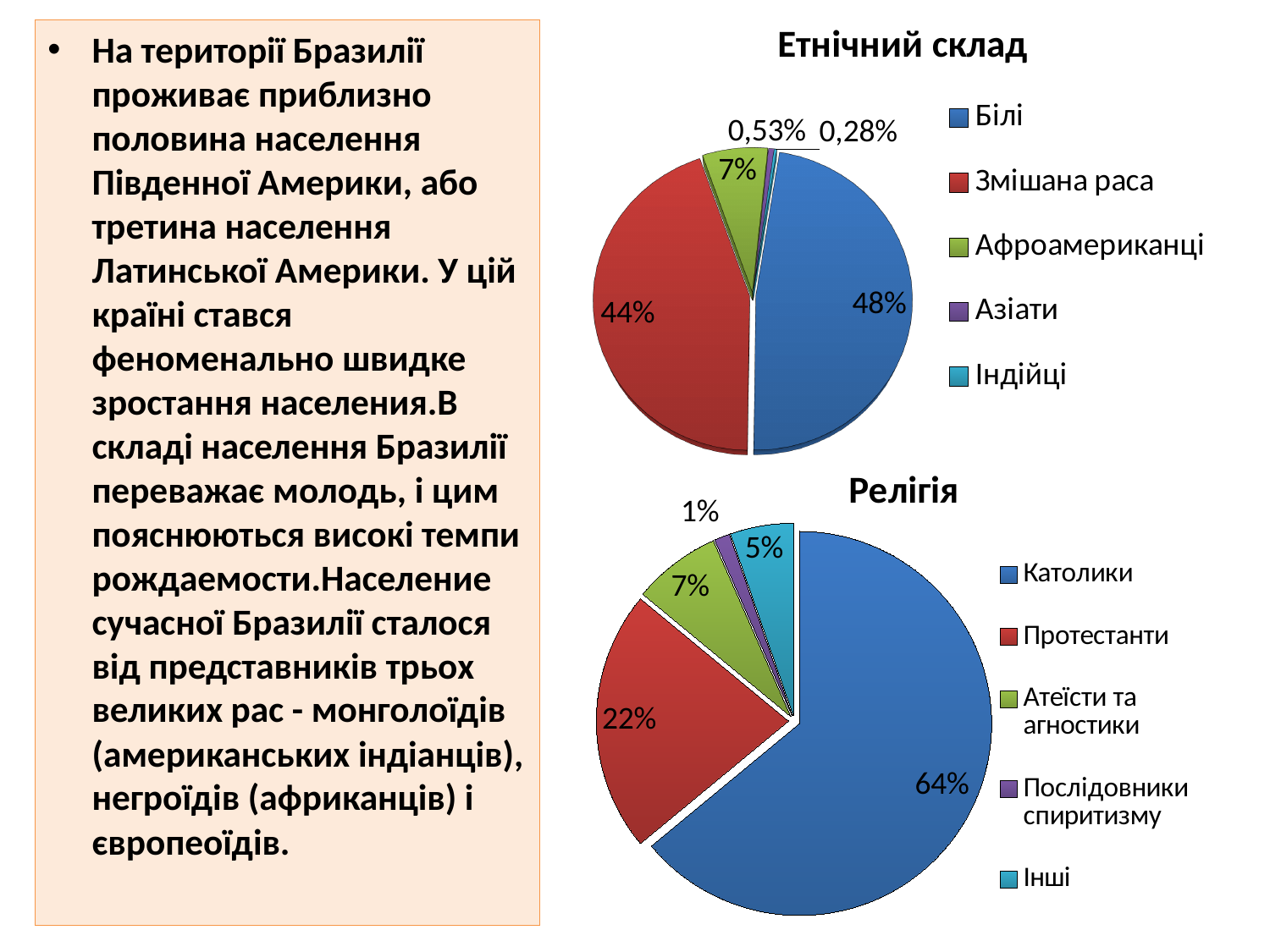
In the 'Етнічний склад' chart, what share is shown for Змішана раса? 44% What type of chart is the 'Релігія' chart? Pie chart In the 'Релігія' chart, what share is shown for Інші? 5% In the 'Етнічний склад' chart, what share is shown for Білі? 48% In the 'Релігія' chart, what share is shown for Протестанти? 22% In the 'Етнічний склад' chart, what is the difference between the shares of Білі and Змішана раса? 4% In the 'Етнічний склад' chart, which category has the largest share? Білі In the 'Етнічний склад' chart, how many categories does the legend list? 5 In the 'Релігія' chart, which is larger: Атеїсти та агностики or Інші? Атеїсти та агностики In the 'Релігія' chart, which category has the smallest share? Послідовники спиритизму In the 'Етнічний склад' chart, what share is shown for Афроамериканці? 7% In the 'Релігія' chart, what share is shown for Католики? 64%